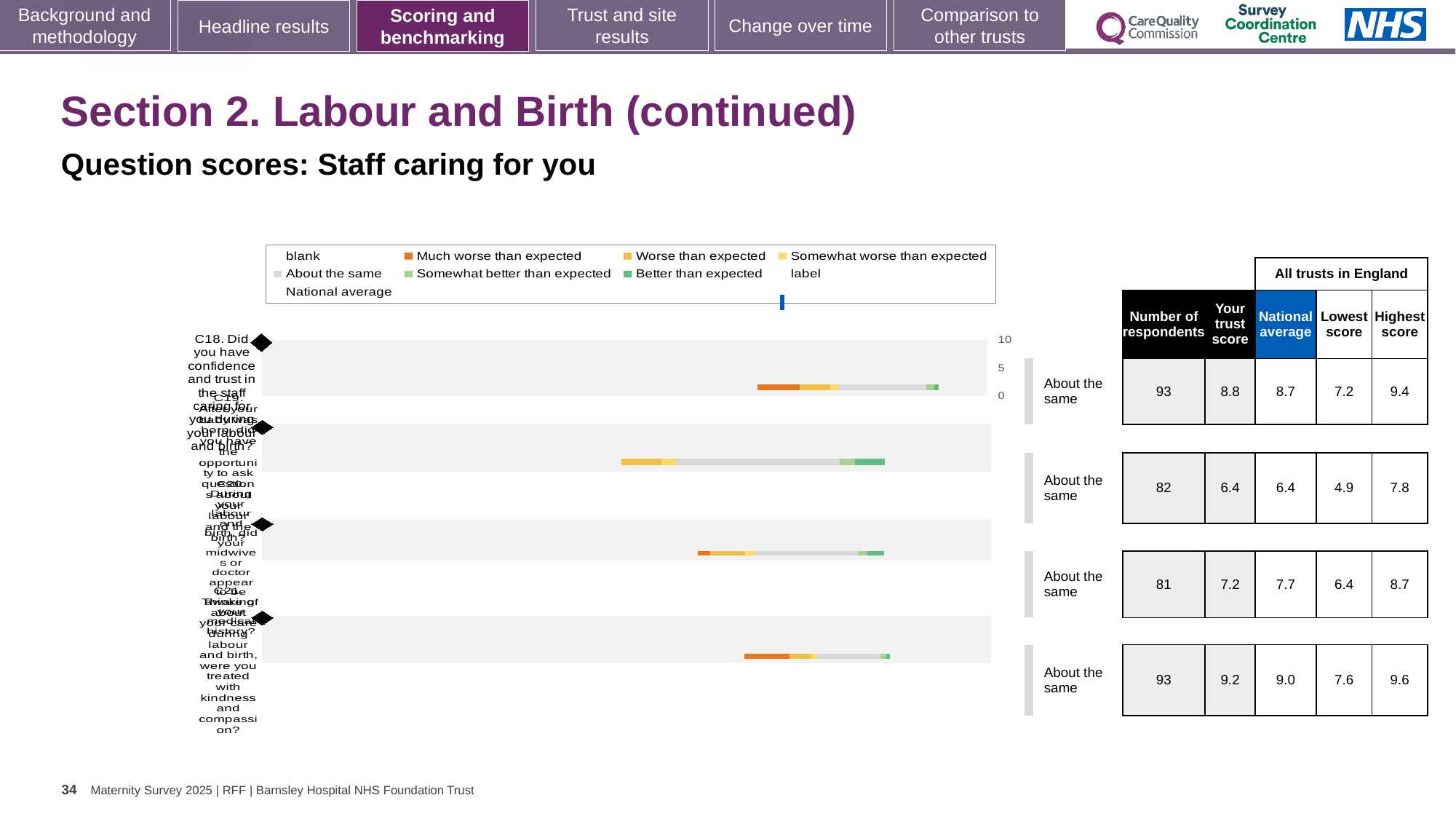
For the third row (C20), which is larger: the trust score or the national average? the national average In the table, what is the 'Your trust score' for the top row (C18)? 8.8 Which row of the table has the lowest 'Your trust score'? the second row (C19), 6.4 What is the benchmark category shown next to every row of the chart? About the same In the table, what is the number of respondents for the second row (C19)? 82 How many questions (rows) are plotted in the chart? 4 Which row of the table has the highest 'Your trust score'? the bottom row (C21), 9.2 In the table, what is the national average for the third row (C20)? 7.7 For the top row (C18), what is the difference between the highest score and the lowest score in the table? 2.2 In the table, what is the highest score for the bottom row (C21)? 9.6 What kind of chart is shown on the slide? bar chart What is the title of the chart section on the slide? Question scores: Staff caring for you